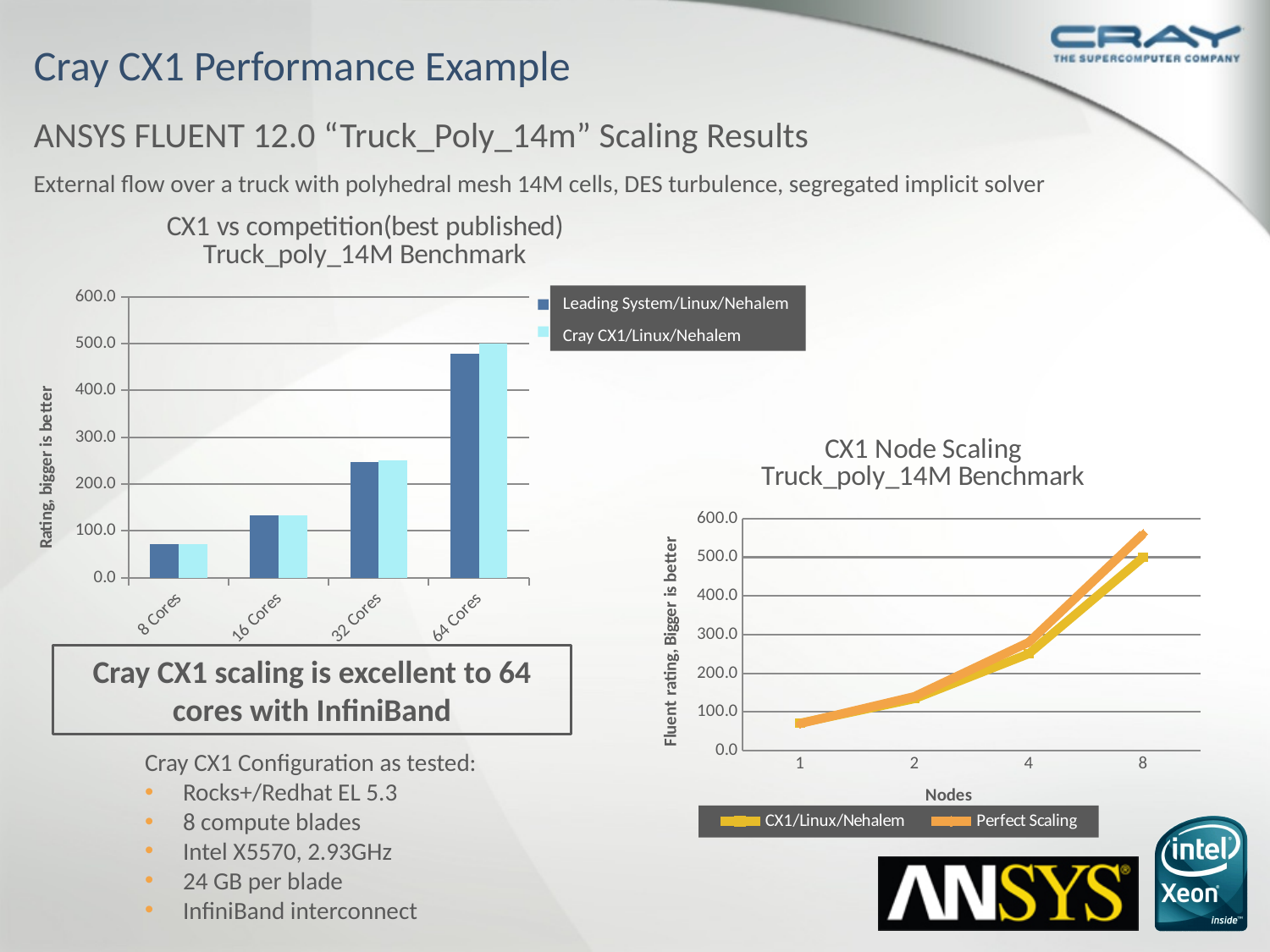
In the 'CX1 Node Scaling' line chart, at 8 nodes, which series has the larger value: CX1/Linux/Nehalem or Perfect Scaling? Perfect Scaling What kind of chart is the 'CX1 vs competition(best published) Truck_poly_14M Benchmark' chart? bar chart In the 'CX1 vs competition' bar chart, how many series does the legend list? 2 In the 'CX1 vs competition' bar chart, how many core-count categories are shown on the x axis? 4 In the 'CX1 vs competition' bar chart, which core count has the highest rating? 64 Cores In the 'CX1 Node Scaling' line chart, do the values rise or fall as the number of nodes increases? rise In the 'CX1 Node Scaling' line chart, how many series does the legend list? 2 In the 'CX1 vs competition' bar chart, is the Cray CX1/Linux/Nehalem value for 64 Cores greater or less than 400.0? greater In the 'CX1 vs competition' bar chart, which core count has the lowest rating? 8 Cores What kind of chart is the 'CX1 Node Scaling Truck_poly_14M Benchmark' chart? line chart In the 'CX1 vs competition' bar chart, is the Leading System/Linux/Nehalem value for 8 Cores greater or less than 100.0? less What is the x-axis title of the 'CX1 Node Scaling' line chart? Nodes